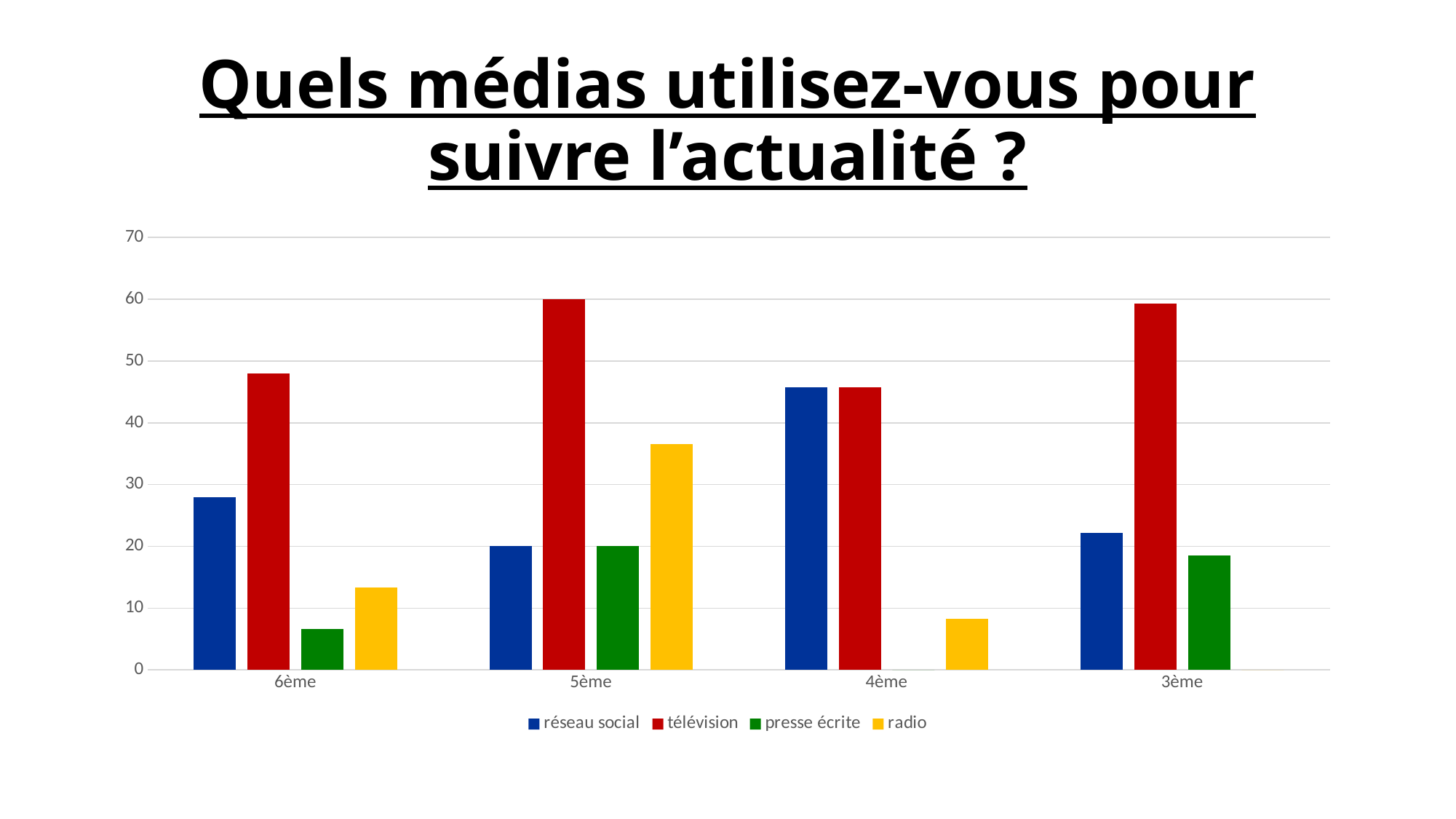
What is the value for télévision in the 5ème category? 60 What kind of chart is shown on the slide? bar chart In the 5ème category, which is larger: radio or presse écrite? radio How many categories (class levels) are shown on the x axis? 4 Which media has the lowest value in the 6ème category? presse écrite Is the value for presse écrite in the 6ème category greater or less than 10? less Is the value for radio in the 5ème category greater or less than 30? greater How many series does the legend list? 4 What is the value for réseau social in the 5ème category? 20 Is the value for télévision in the 6ème category greater or less than 40? greater Which media has the highest value in the 6ème category? télévision Which colour represents télévision in the legend? red